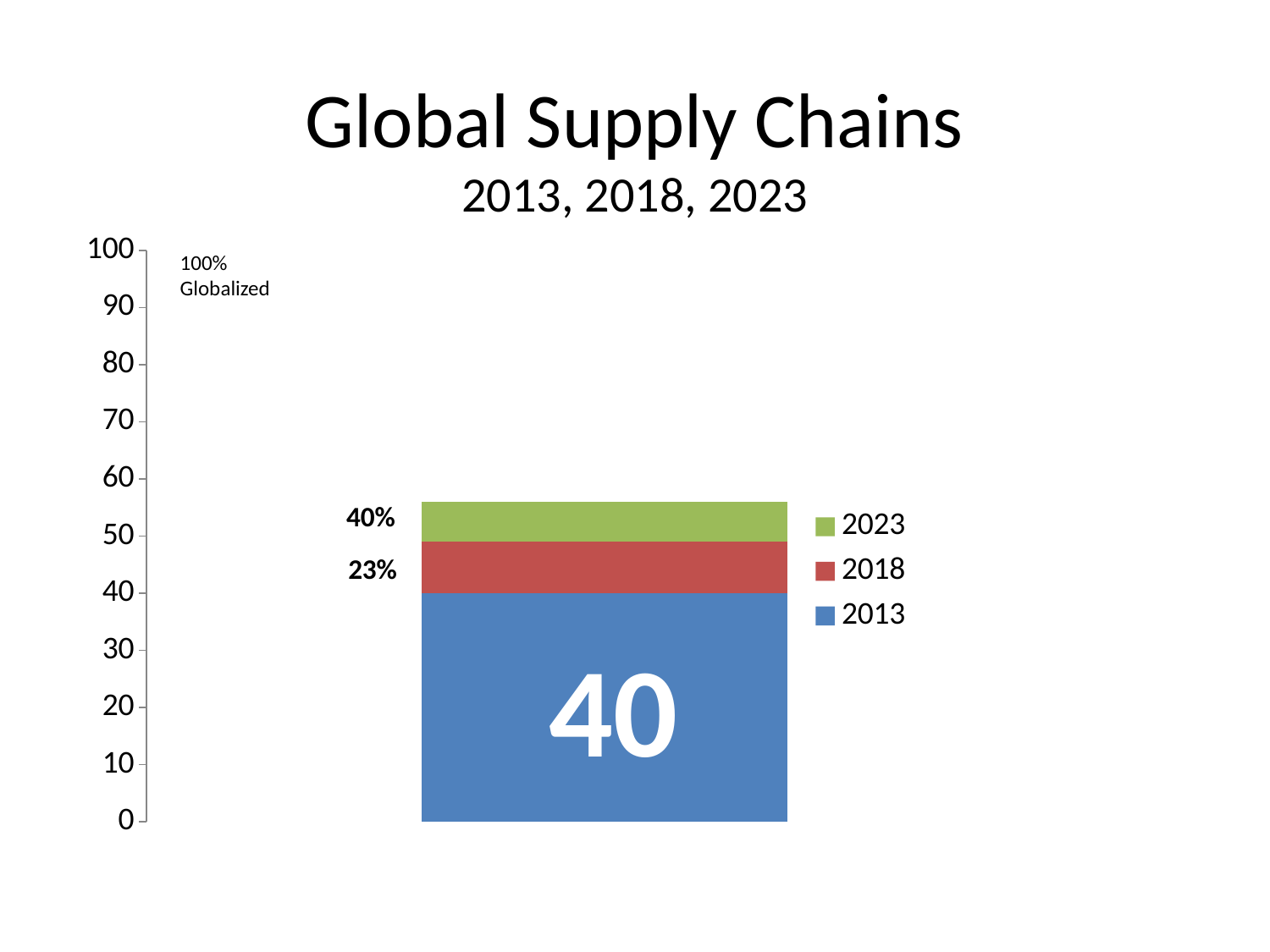
What is the value of the 2013 segment in the stacked bar? 40 Is the total height of the stacked bar greater or less than 60? less Which colour represents the 2023 series in the legend? Green What is the title of the chart? Global Supply Chains How many series does the legend list? 3 Is the total height of the stacked bar greater or less than 50? greater Which series has the largest segment in the stacked bar? 2013 What kind of chart is shown on the slide? Stacked bar chart How many bars are plotted in the chart? 1 Which segment is larger, 2013 or 2023? 2013 Which segment is larger, 2013 or 2018? 2013